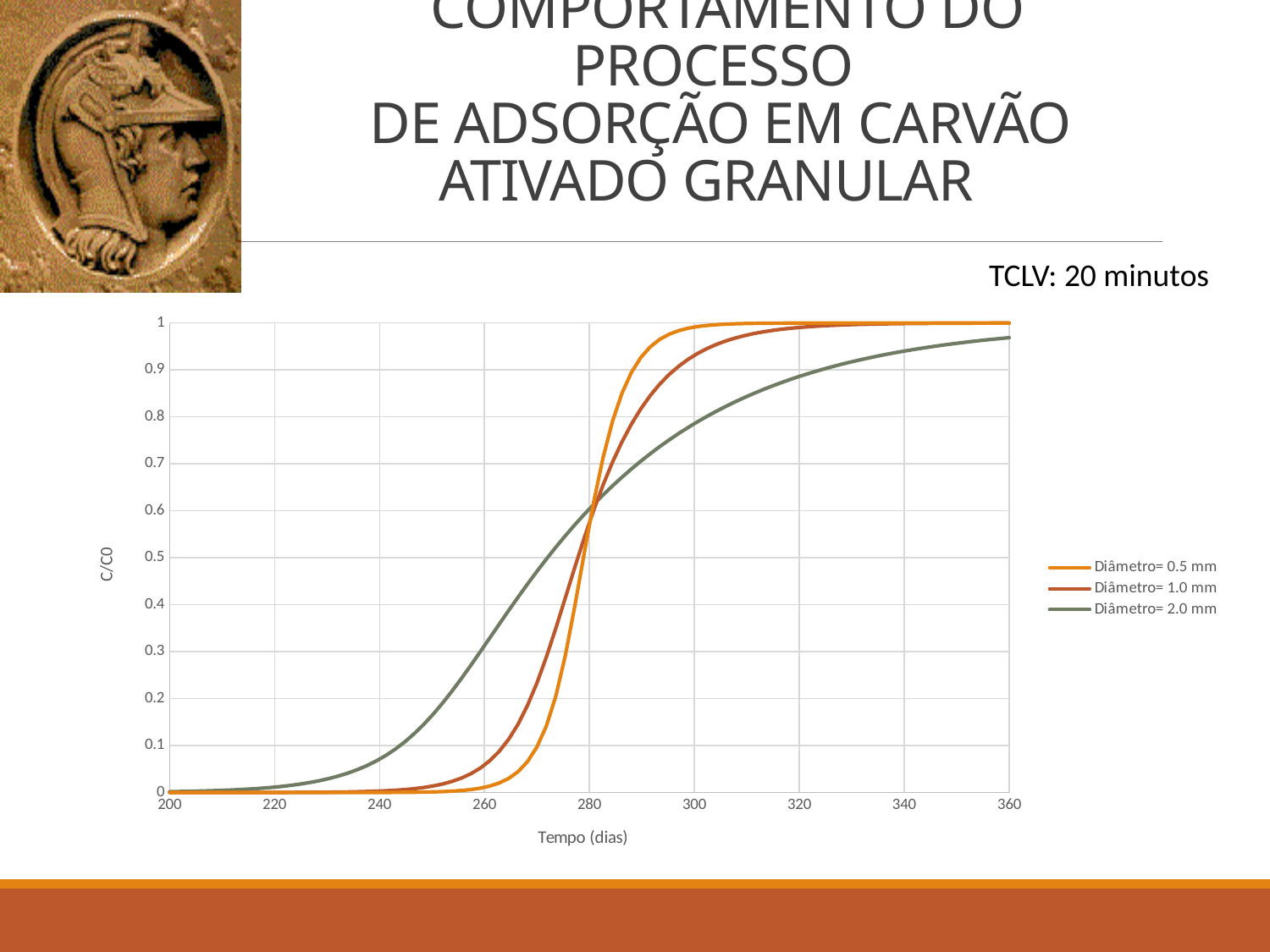
At 340 days, is the C/C0 value for Diâmetro= 2.0 mm greater or less than 0.9? greater At 300 days, which series has the higher C/C0 value, Diâmetro= 0.5 mm or Diâmetro= 2.0 mm? Diâmetro= 0.5 mm At 260 days, which series has the higher C/C0 value, Diâmetro= 2.0 mm or Diâmetro= 0.5 mm? Diâmetro= 2.0 mm What are the three series listed in the legend? Diâmetro= 0.5 mm, Diâmetro= 1.0 mm, Diâmetro= 2.0 mm At 260 days, is the C/C0 value for Diâmetro= 1.0 mm greater or less than 0.1? less At 260 days, is the C/C0 value for Diâmetro= 0.5 mm greater or less than 0.1? less How many series does the legend list? 3 What is the title of the x axis? Tempo (dias) Do the C/C0 values for Diâmetro= 0.5 mm rise or fall as Tempo (dias) increases? rise What kind of chart is shown on the slide? line chart Do the C/C0 values for Diâmetro= 2.0 mm rise or fall as Tempo (dias) increases? rise